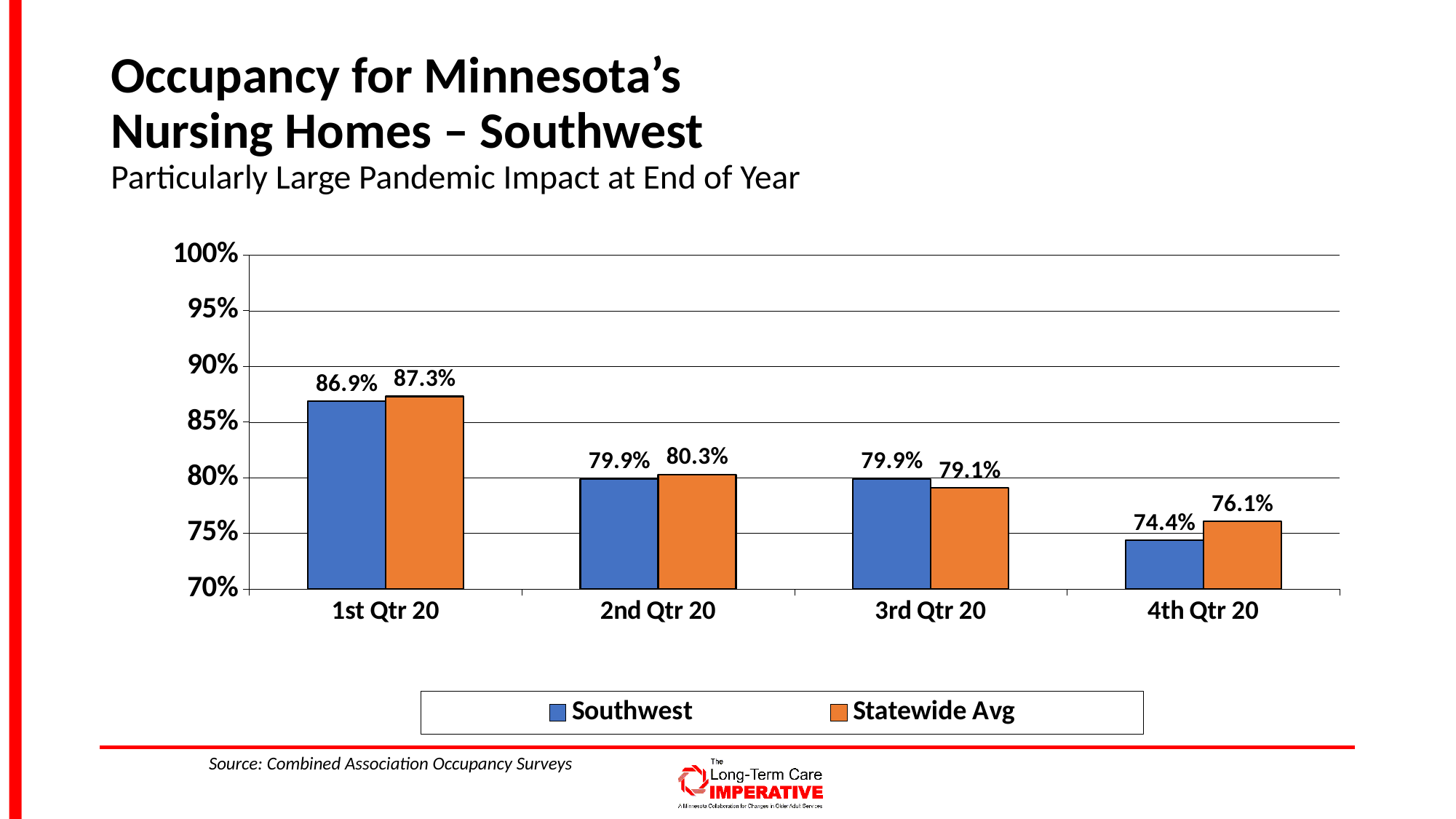
What is the Statewide Avg occupancy value for 4th Qtr 20? 76.1% Which is larger in 3rd Qtr 20, the Southwest value or the Statewide Avg value? Southwest How many series does the legend list? 2 In which quarter is the Southwest occupancy lowest? 4th Qtr 20 What is the difference between the Statewide Avg and Southwest values in 4th Qtr 20? 1.7% What is the difference between the Southwest values for 1st Qtr 20 and 2nd Qtr 20? 7.0% What is the Statewide Avg value for 3rd Qtr 20? 79.1% What is the Southwest occupancy value for 1st Qtr 20? 86.9% In which quarter is the Statewide Avg occupancy highest? 1st Qtr 20 Is the Southwest value for 4th Qtr 20 greater or less than 75%? less How many quarters are shown on the x axis? 4 What kind of chart is shown on the slide? bar chart